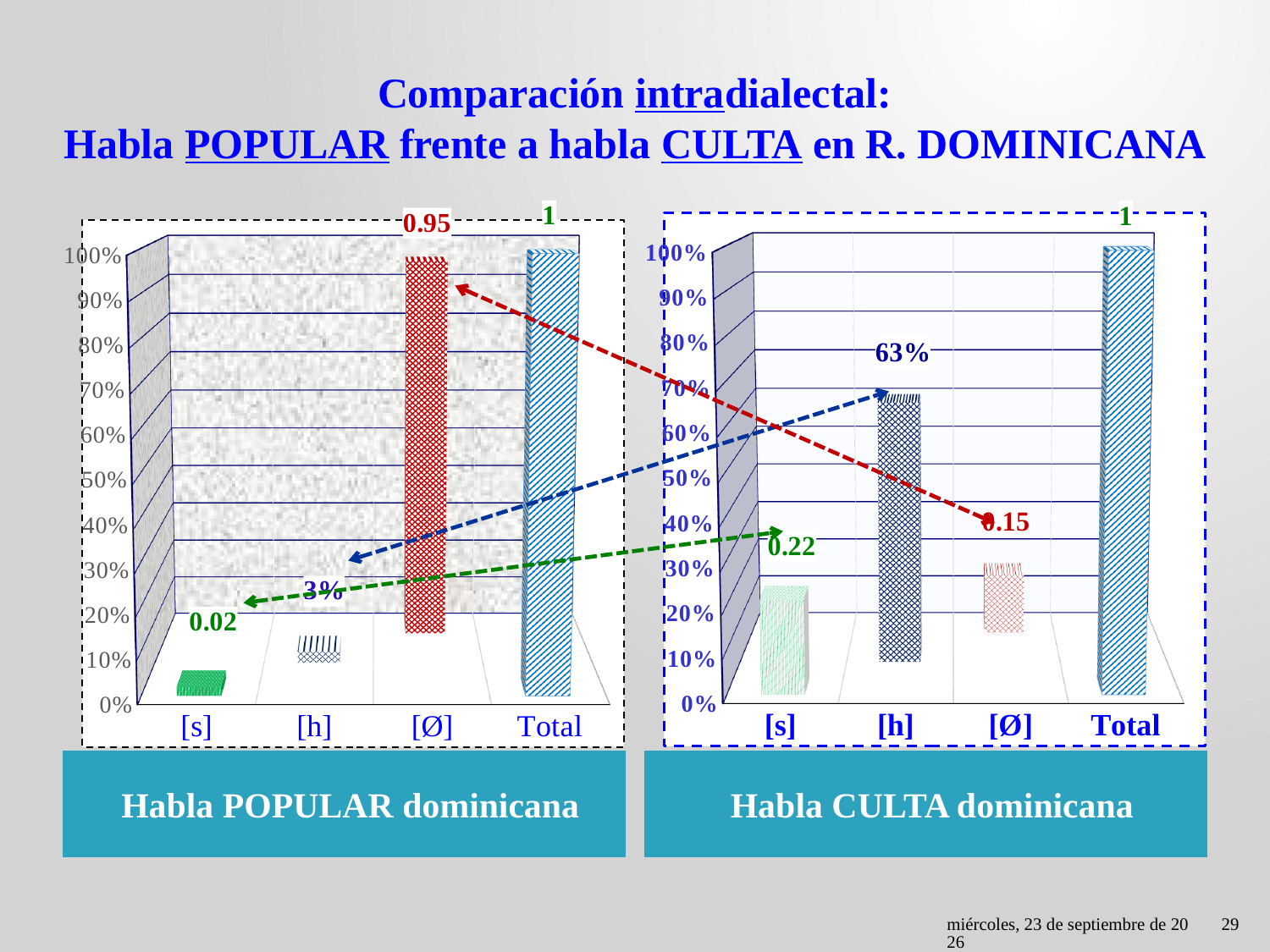
In the Habla CULTA dominicana chart, what value is labelled for [Ø]? 0.15 In the Habla CULTA dominicana chart, excluding Total, which category has the highest bar? [h] In the Habla POPULAR dominicana chart, what value is labelled for [Ø]? 0.95 In the Habla CULTA dominicana chart, is the value for [h] greater or less than 50%? greater How many categories are shown on the x axis of the Habla POPULAR dominicana chart? 4 In the Habla CULTA dominicana chart, what is the difference between the labelled values for [s] and [Ø]? 0.07 What kind of chart is the Habla CULTA dominicana chart? bar chart In the Habla CULTA dominicana chart, what value is labelled for [s]? 0.22 In the Habla POPULAR dominicana chart, which is larger, the value for [h] or the value for [Ø]? [Ø] In the Habla POPULAR dominicana chart, what value is labelled for [s]? 0.02 In the Habla CULTA dominicana chart, what value is labelled for [h]? 63% In the Habla POPULAR dominicana chart, which category has the lowest bar? [s]